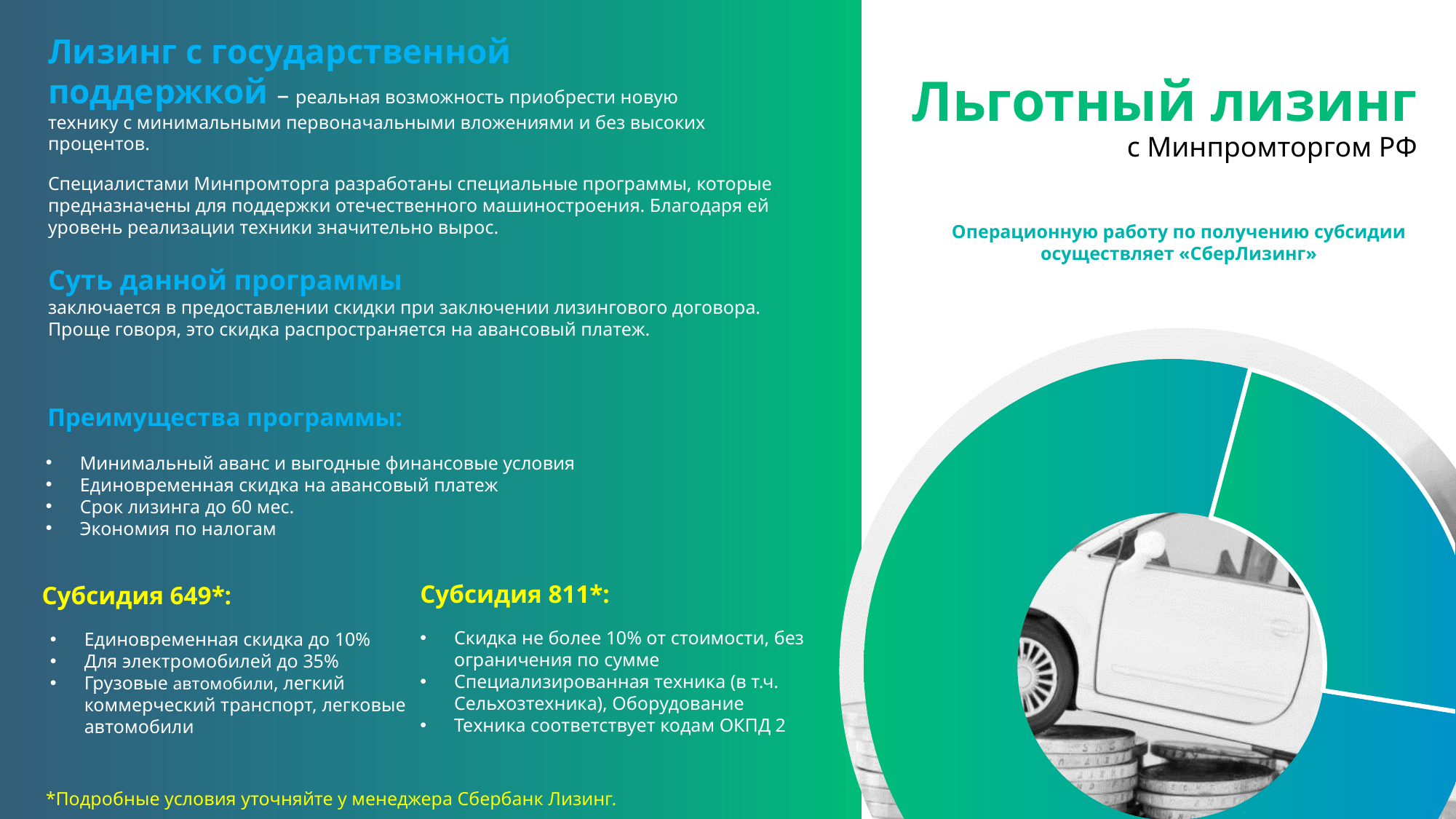
In the doughnut chart on the right side of the slide, which slice is larger, the green one or the blue one? the green one Does the doughnut chart on the right side of the slide have a legend? No Does the doughnut chart on the right side of the slide show any data labels? No How many slices does the doughnut chart on the right side of the slide have? 2 What kind of chart is shown on the right side of the slide? doughnut chart